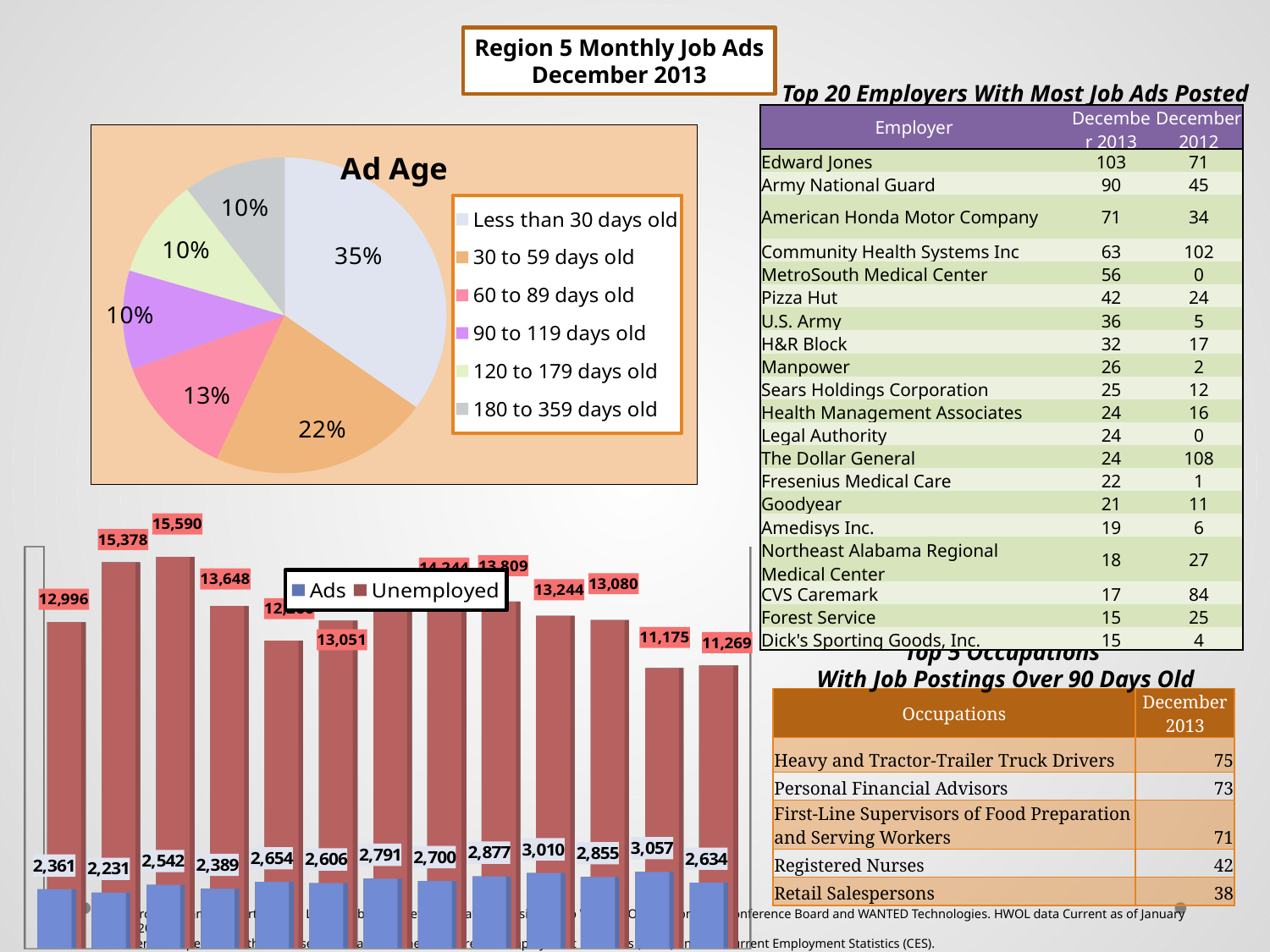
What kind of chart is the "Ad Age" chart? pie chart In the "Ad Age" pie chart, what share of ads are less than 30 days old? 35% In the "Ad Age" pie chart, what share of ads are 60 to 89 days old? 13% In the bottom-left bar chart, what is the highest value shown for the Unemployed series? 15,590 What are the two series named in the legend of the bottom-left bar chart? Ads and Unemployed In the "Ad Age" pie chart, what share of ads are 30 to 59 days old? 22% How many series does the legend of the bottom-left bar chart list? 2 In the "Ad Age" pie chart, which category has the largest slice? Less than 30 days old In the bottom-left bar chart, what is the lowest value shown for the Ads series? 2,231 In the "Ad Age" pie chart, how many percentage points larger is the "Less than 30 days old" slice than the "30 to 59 days old" slice? 13 percentage points What kind of chart is the chart at the bottom left of the slide? bar chart How many categories does the "Ad Age" pie chart show? 6